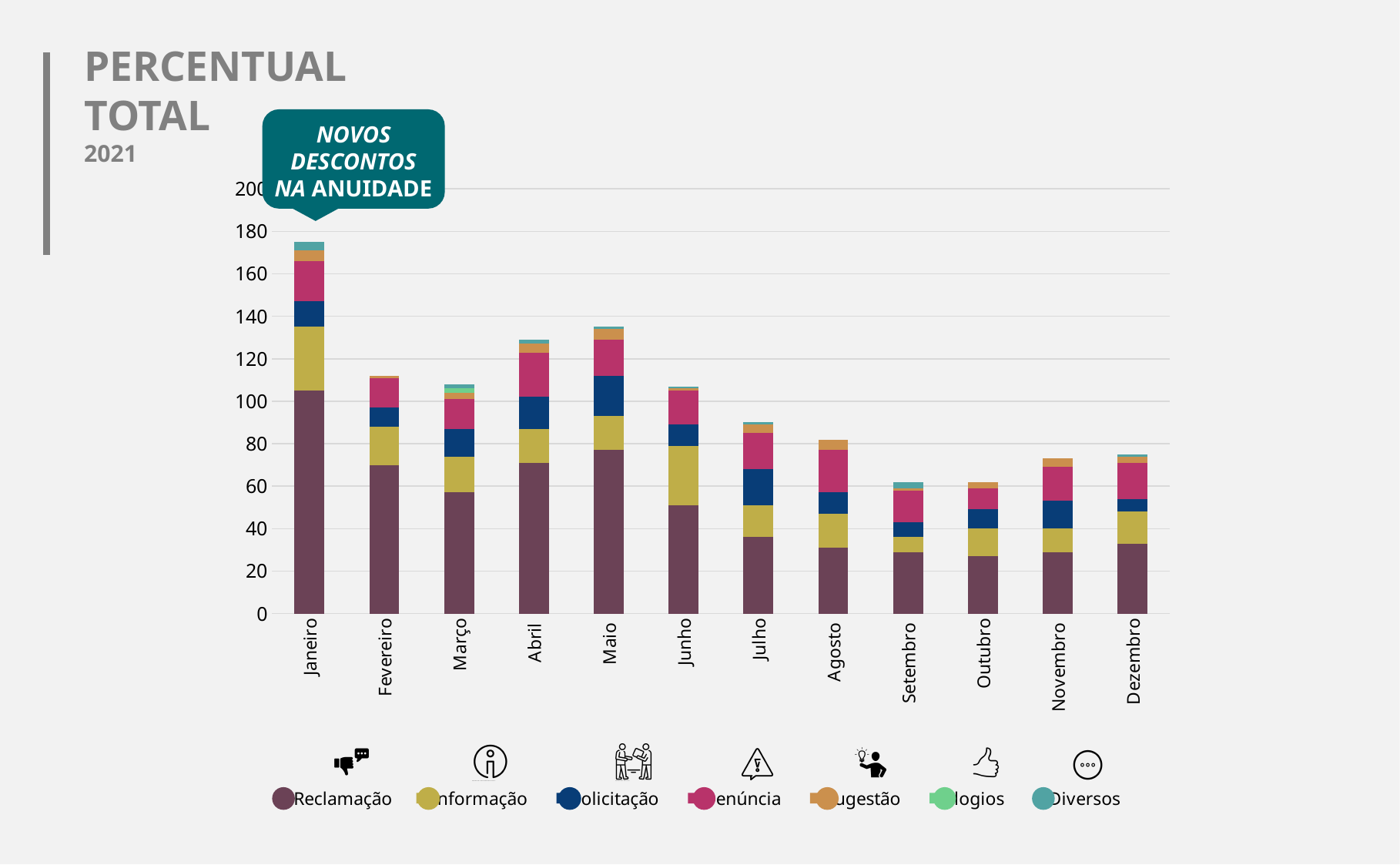
Is the total for Janeiro greater or less than 160? greater Which month has the larger total bar, Junho or Julho? Junho How many months (categories) are plotted on the x axis? 12 From Junho to Setembro, do the total bars rise or fall? fall What kind of chart is shown on the slide? Stacked bar chart Is the total for Julho greater or less than 100? less Is the total for Setembro greater or less than 80? less How many series does the legend list? 7 Which month has the highest total bar? Janeiro Which month does the callout 'NOVOS DESCONTOS NA ANUIDADE' point to? Janeiro